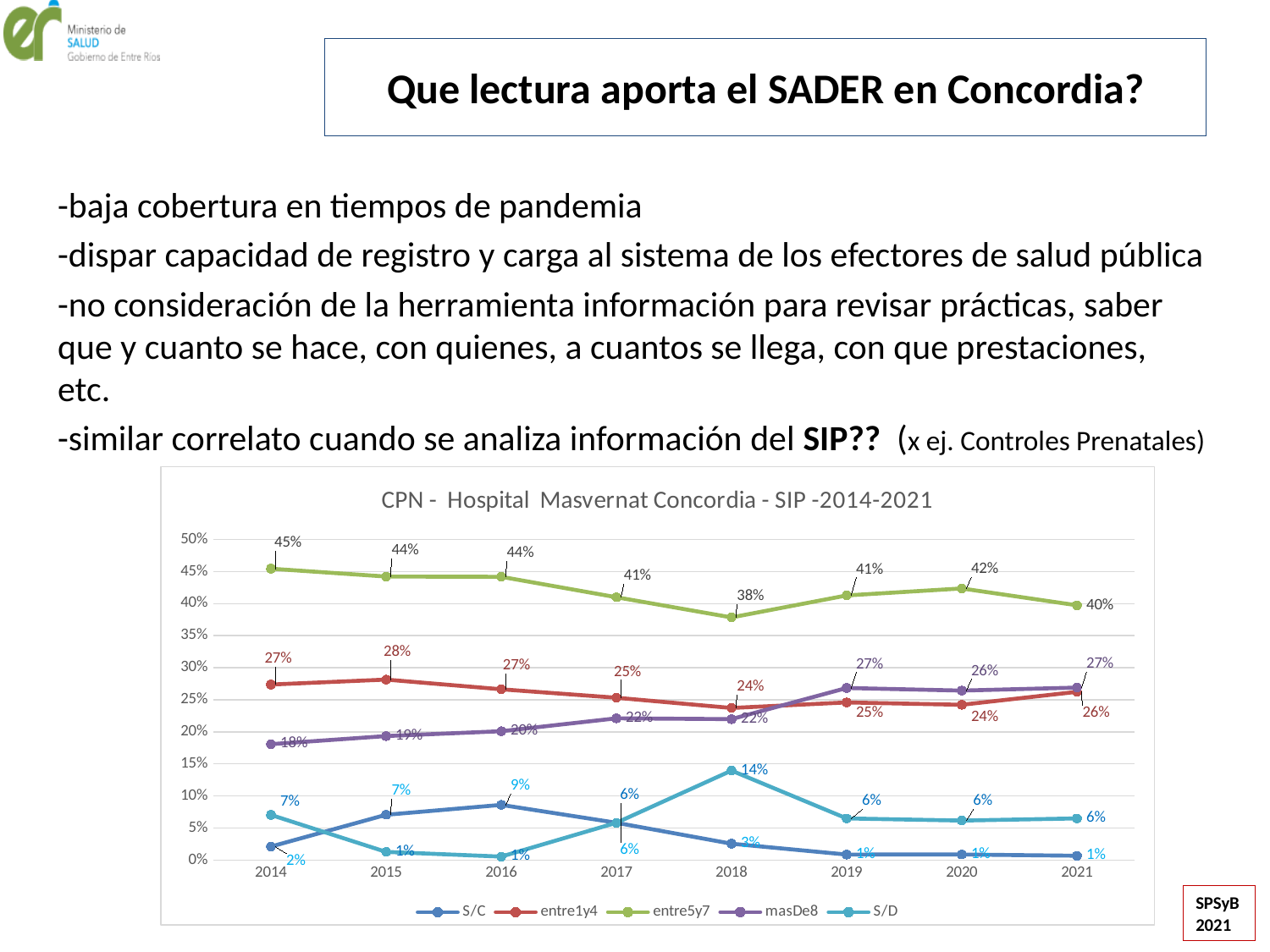
How many years are plotted along the x axis of the chart? 8 How many series does the chart legend list? 5 What is the title of the chart? CPN - Hospital Masvernat Concordia - SIP -2014-2021 In which year does the S/C series reach its highest value? 2016 In which year does the entre5y7 series reach its lowest value? 2018 What is the difference between the entre5y7 value in 2014 and its value in 2018? 7% What type of chart is shown on the slide? line chart Which series has the higher value in 2019, entre1y4 or masDe8? masDe8 Is the value of the entre5y7 series in 2020 greater or less than 35%? greater What is the value of the masDe8 series in 2021? 27% What is the value of the entre5y7 series in 2014? 45% What is the value of the S/D series in 2018? 14%